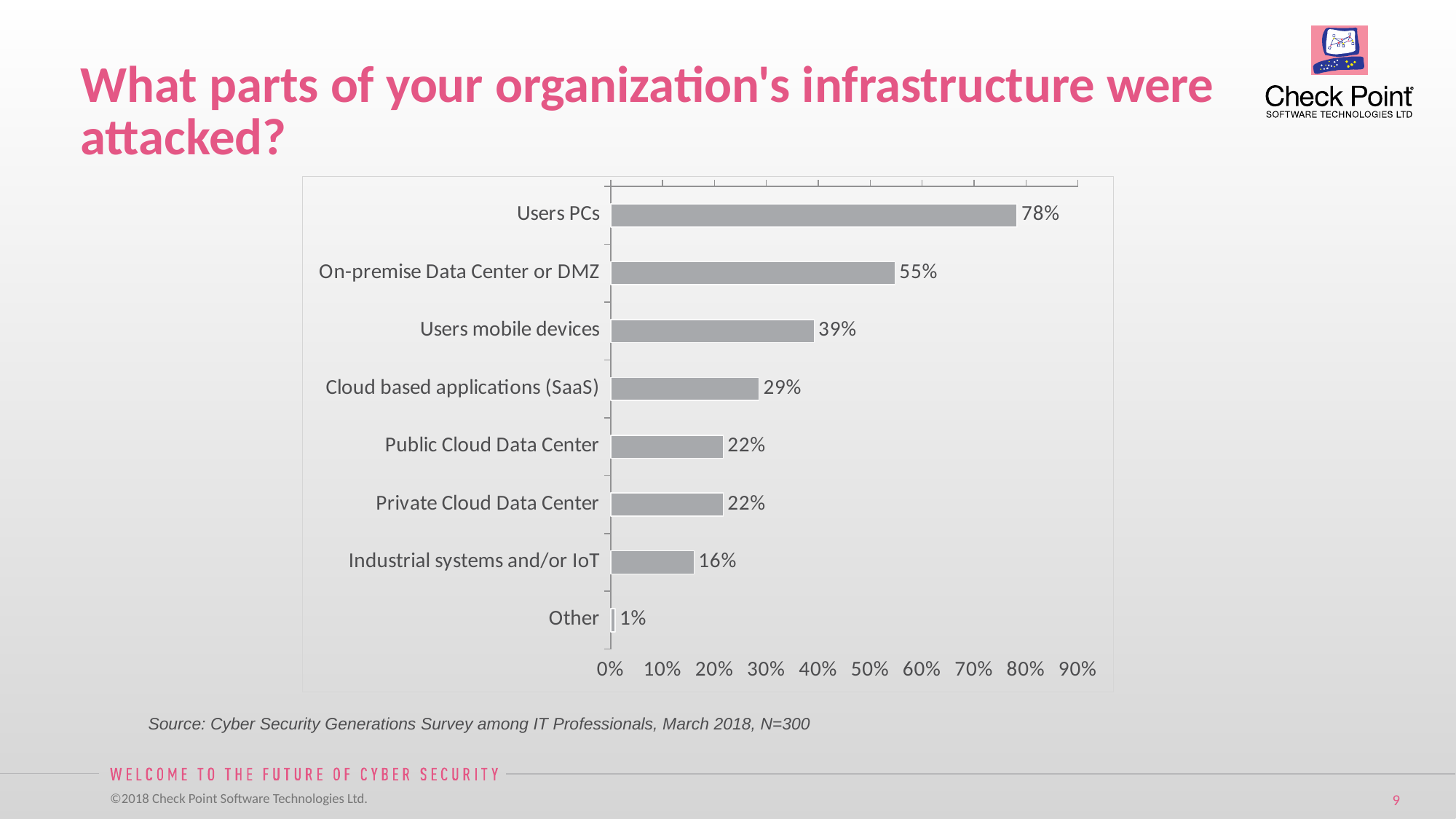
How many categories are shown in the chart? 8 What is the value for Industrial systems and/or IoT? 16% What is the value for Cloud based applications (SaaS)? 29% What is the title of the slide containing the chart? What parts of your organization's infrastructure were attacked? Which is larger, the value for Users mobile devices or the value for Cloud based applications (SaaS)? Users mobile devices Which category has the highest value? Users PCs Which category has the lowest value? Other What is the difference between the values for Users PCs and Users mobile devices? 39% What is the value for Users PCs? 78% What is the value for On-premise Data Center or DMZ? 55% What is the difference between the values for On-premise Data Center or DMZ and Public Cloud Data Center? 33% What kind of chart is shown on the slide? Bar chart